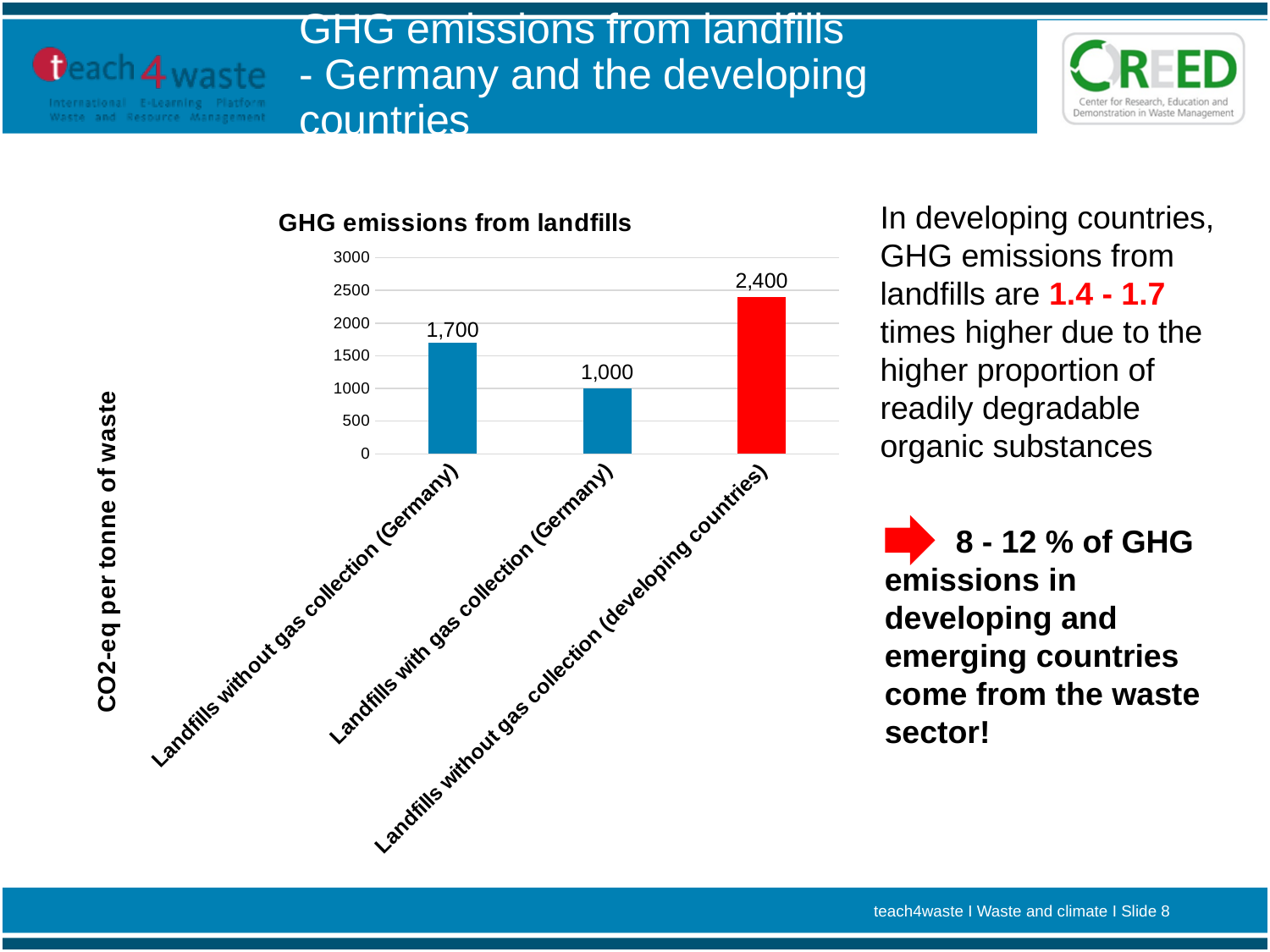
What is the value for Landfills without gas collection (Germany)? 1,700 What is the difference between Landfills without gas collection (developing countries) and Landfills without gas collection (Germany)? 700 What kind of chart is shown on the slide? Bar chart What is the difference between Landfills without gas collection (Germany) and Landfills with gas collection (Germany)? 700 What is the title of the chart? GHG emissions from landfills Which category has the highest value? Landfills without gas collection (developing countries) Which is larger: Landfills with gas collection (Germany) or Landfills without gas collection (developing countries)? Landfills without gas collection (developing countries) How many categories are shown in the chart? 3 What is the value for Landfills with gas collection (Germany)? 1,000 Is the value for Landfills without gas collection (developing countries) greater or less than 2000? greater Which category has the lowest value? Landfills with gas collection (Germany) What is the value for Landfills without gas collection (developing countries)? 2,400